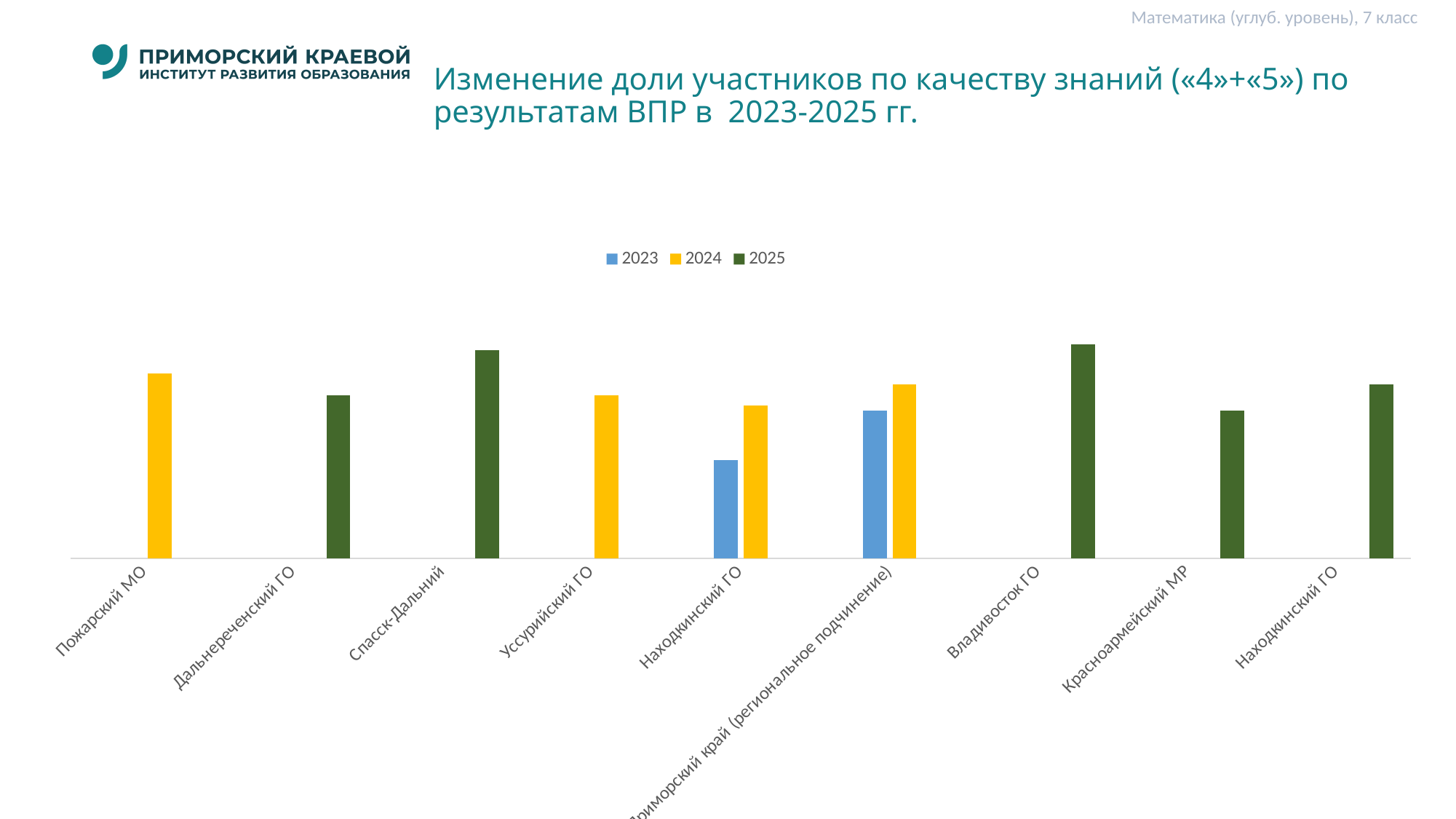
For Находкинский ГО (the fifth category), which is larger: the 2023 value or the 2024 value? 2024 What kind of chart is shown on the slide? bar chart Which is larger: the 2024 value for Пожарский МО or the 2024 value for Находкинский ГО (fifth category)? Пожарский МО How many categories have a bar for the 2023 series? 2 Which years are listed in the legend? 2023, 2024, 2025 How many series does the legend list? 3 For Приморский край (региональное подчинение), which is larger: the 2023 value or the 2024 value? 2024 For Находкинский ГО (the fifth category), does the value rise or fall from 2023 to 2024? rise Among the categories with a 2025 bar, which has the lowest 2025 value? Красноармейский МР How many categories are shown on the x axis? 9